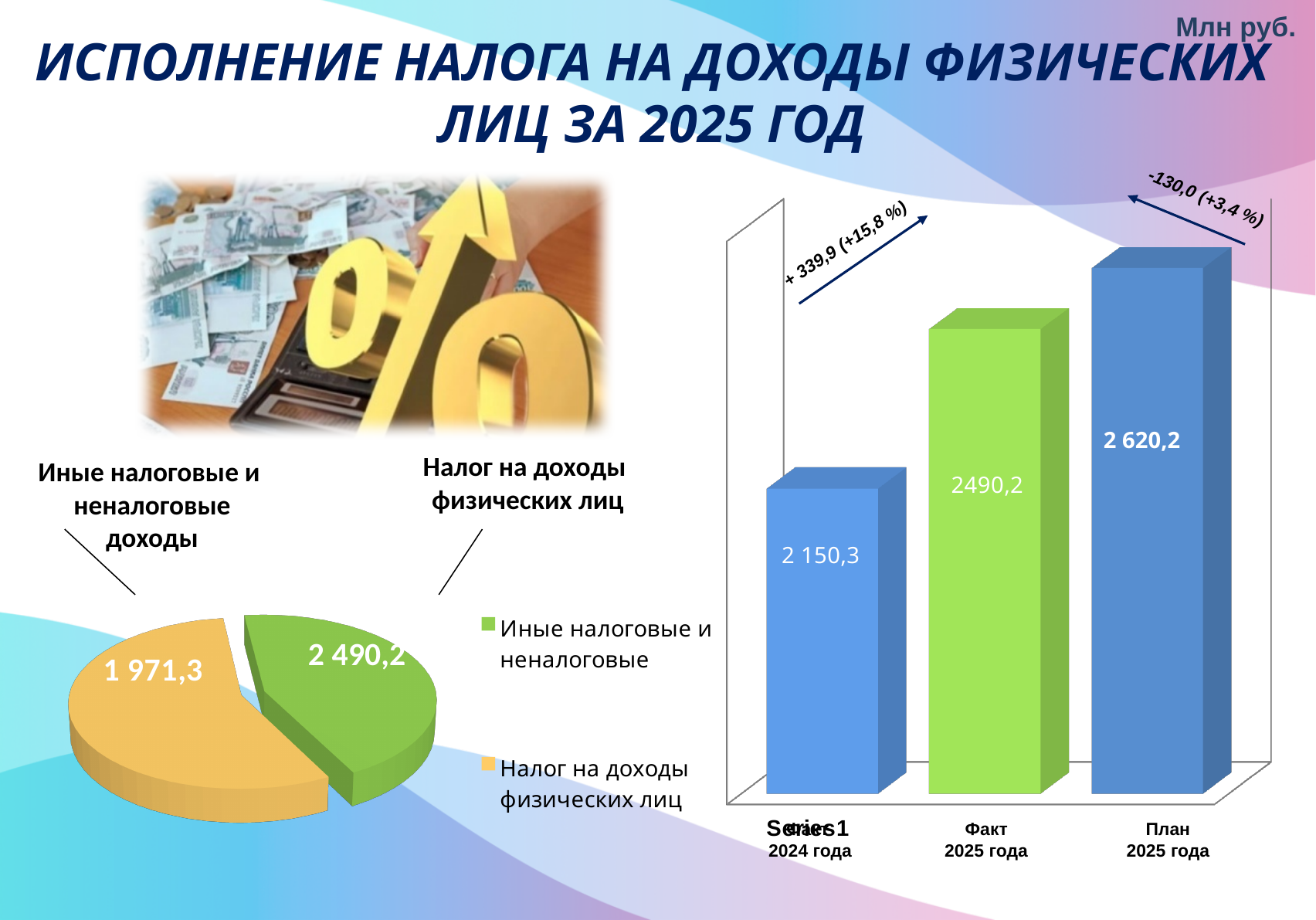
On the bar chart on the right, do the values rise or fall from left to right? Rise On the bar chart on the right, how many bars are shown? 3 On the bar chart on the right, what is the difference between Факт 2025 года and Факт 2024 года? 339,9 On the bar chart on the right, what is the value for Факт 2025 года? 2490,2 On the pie chart on the left, how many slices are there? 2 What kind of chart is the chart on the right of the slide? Bar chart On the bar chart on the right, what is the difference between План 2025 года and Факт 2025 года? 130,0 On the bar chart on the right, which category has the lowest value? Факт 2024 года On the pie chart on the left, what is the total of the two slice values? 4 461,5 On the bar chart on the right, what is the value for План 2025 года? 2 620,2 On the bar chart on the right, which category has the highest value? План 2025 года On the bar chart on the right, what is the value for Факт 2024 года? 2 150,3